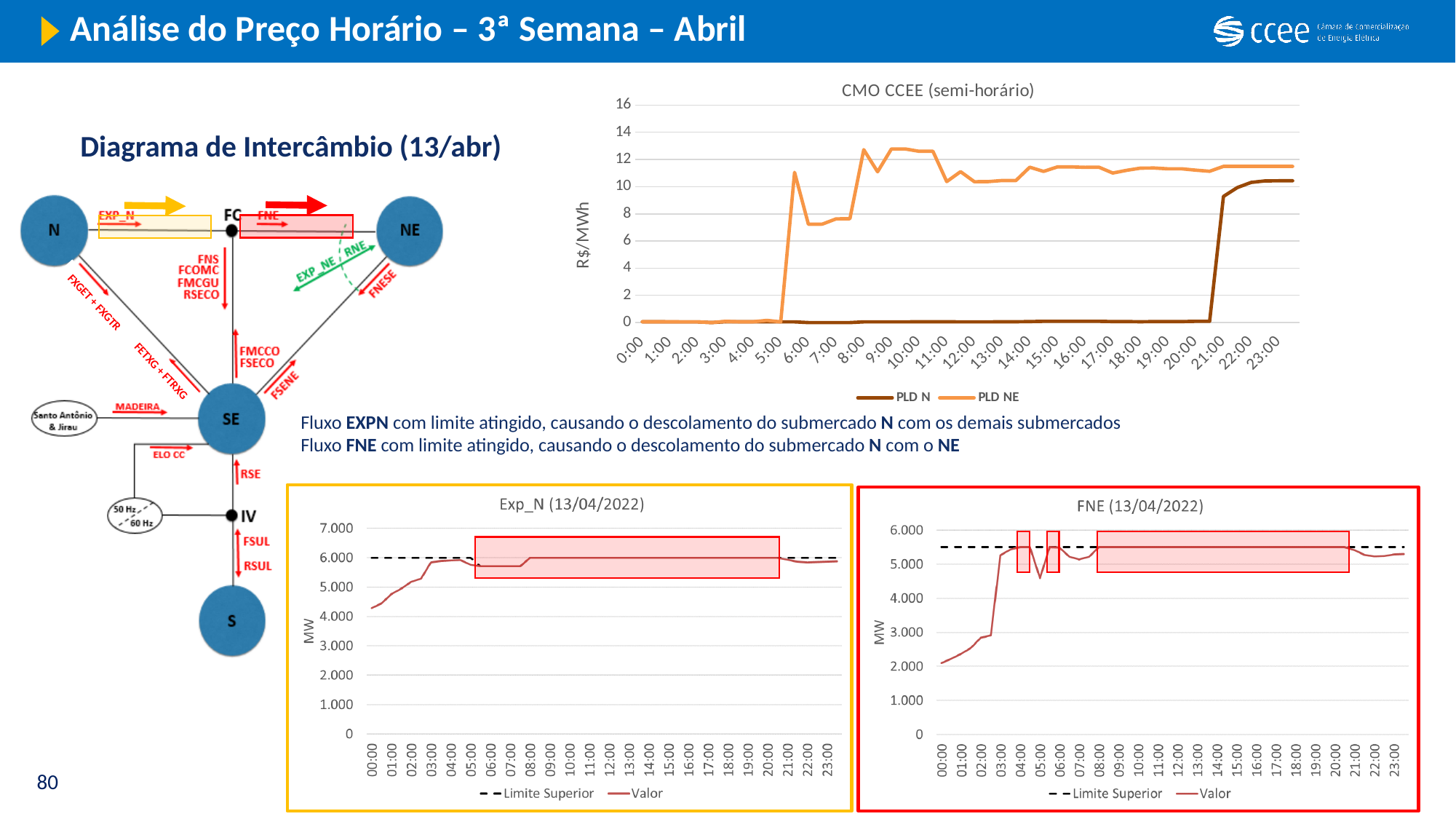
What kind of chart is the 'CMO CCEE (semi-horário)' chart? line chart In the 'CMO CCEE (semi-horário)' chart, is the value of PLD N at 22:00 greater or less than 8? greater In the 'FNE (13/04/2022)' chart, is the Valor at 12:00 greater or less than 5.000? greater In the 'CMO CCEE (semi-horário)' chart, is the value of PLD NE at 10:00 greater or less than 10? greater How many series does the legend of the 'Exp_N (13/04/2022)' chart list? 2 In the 'CMO CCEE (semi-horário)' chart, which series has the larger value at 12:00, PLD N or PLD NE? PLD NE In the 'CMO CCEE (semi-horário)' chart, does the PLD N line rise or fall between 20:00 and 22:00? rises How many series does the legend of the 'CMO CCEE (semi-horário)' chart list? 2 What are the two series named in the legend of the 'CMO CCEE (semi-horário)' chart? PLD N and PLD NE